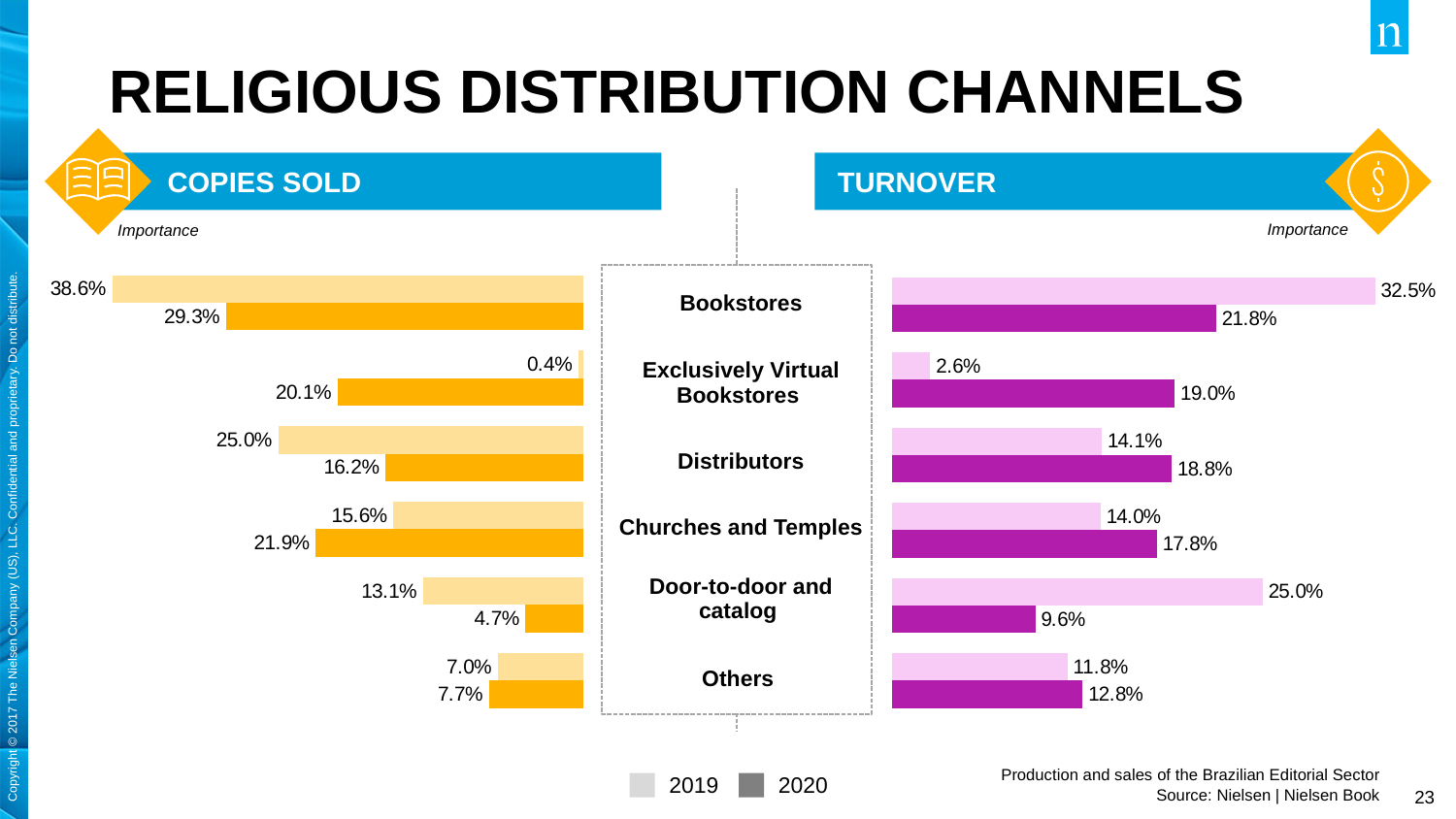
In the Copies Sold chart, which is larger for Churches and Temples, the 2019 value or the 2020 value? 2020 In the Copies Sold chart, what is the 2019 value for Bookstores? 38.6% What kind of chart is the Turnover chart? Bar chart In the Copies Sold chart, what is the 2020 value for Door-to-door and catalog? 4.7% In the Turnover chart, what is the 2020 value for Exclusively Virtual Bookstores? 19.0% In the Turnover chart, which is larger for Distributors, the 2019 value or the 2020 value? 2020 In the Turnover chart, what is the difference between the 2019 and 2020 values for Door-to-door and catalog? 15.4% In the Copies Sold chart, what is the difference between the 2019 and 2020 values for Exclusively Virtual Bookstores? 19.7% How many categories are shown in the Copies Sold chart? 6 In the Turnover chart, which category has the highest 2019 value? Bookstores How many series does the legend list? 2 In the Copies Sold chart, which category has the lowest 2019 value? Exclusively Virtual Bookstores